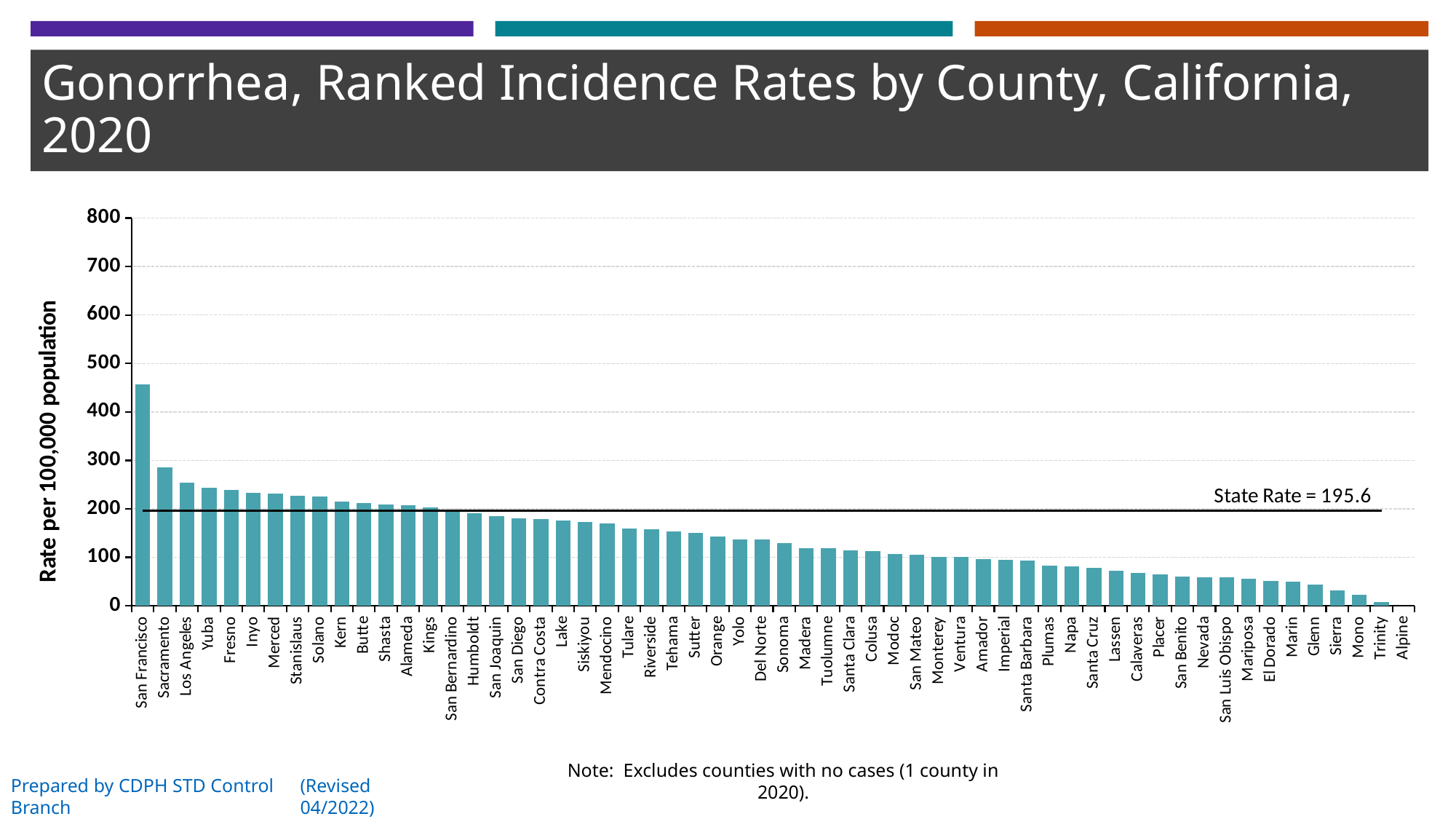
Do the bar values rise or fall moving from left to right along the x axis? Fall Which county has the higher rate, San Francisco or Sacramento? San Francisco Which county has the higher rate, Kern or Marin? Kern Is the value for Marin greater or less than 100? less What kind of chart is shown on the slide? Bar chart Is the value for Orange greater or less than 200? less Is the value for San Francisco greater or less than 400? greater Which county has the highest gonorrhea incidence rate in the chart? San Francisco What is the state rate shown by the horizontal line on the chart? 195.6 What is the label on the vertical axis of the chart? Rate per 100,000 population